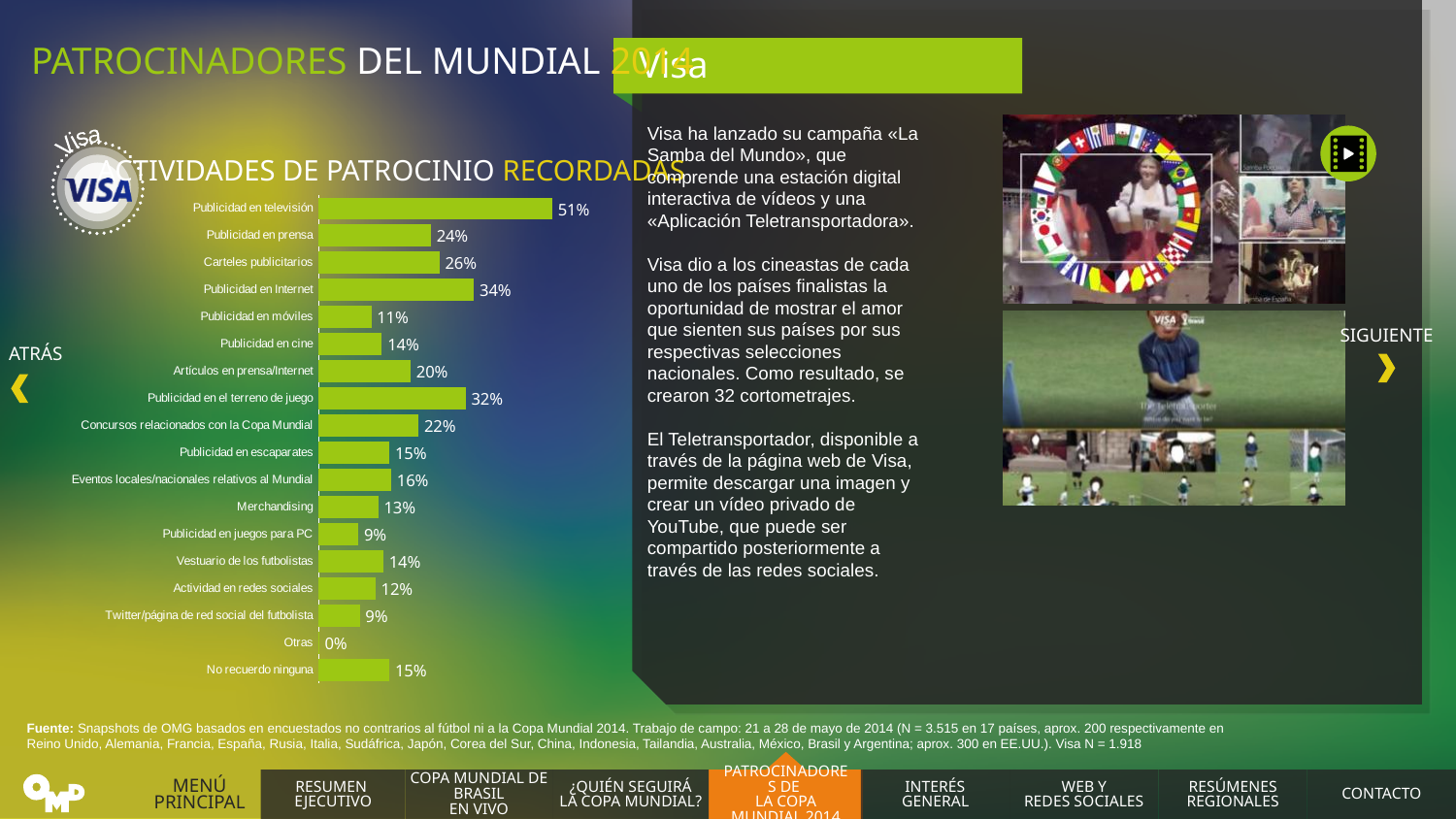
What is the difference between the values for Publicidad en televisión and Publicidad en Internet? 17% What value is shown for Publicidad en Internet? 34% What value is shown for No recuerdo ninguna? 15% What is the difference between the values for Publicidad en cine and Publicidad en juegos para PC? 5% What type of chart is shown on the slide? Bar chart How many categories are shown in the bar chart? 18 Which category has the highest value in the chart? Publicidad en televisión Which is larger, the value for Publicidad en el terreno de juego or the value for Concursos relacionados con la Copa Mundial? Publicidad en el terreno de juego What percentage is shown for Merchandising? 13% Which category has the lowest value in the chart? Otras What percentage is shown for Publicidad en televisión? 51% Which is larger, the value for Carteles publicitarios or the value for Publicidad en prensa? Carteles publicitarios